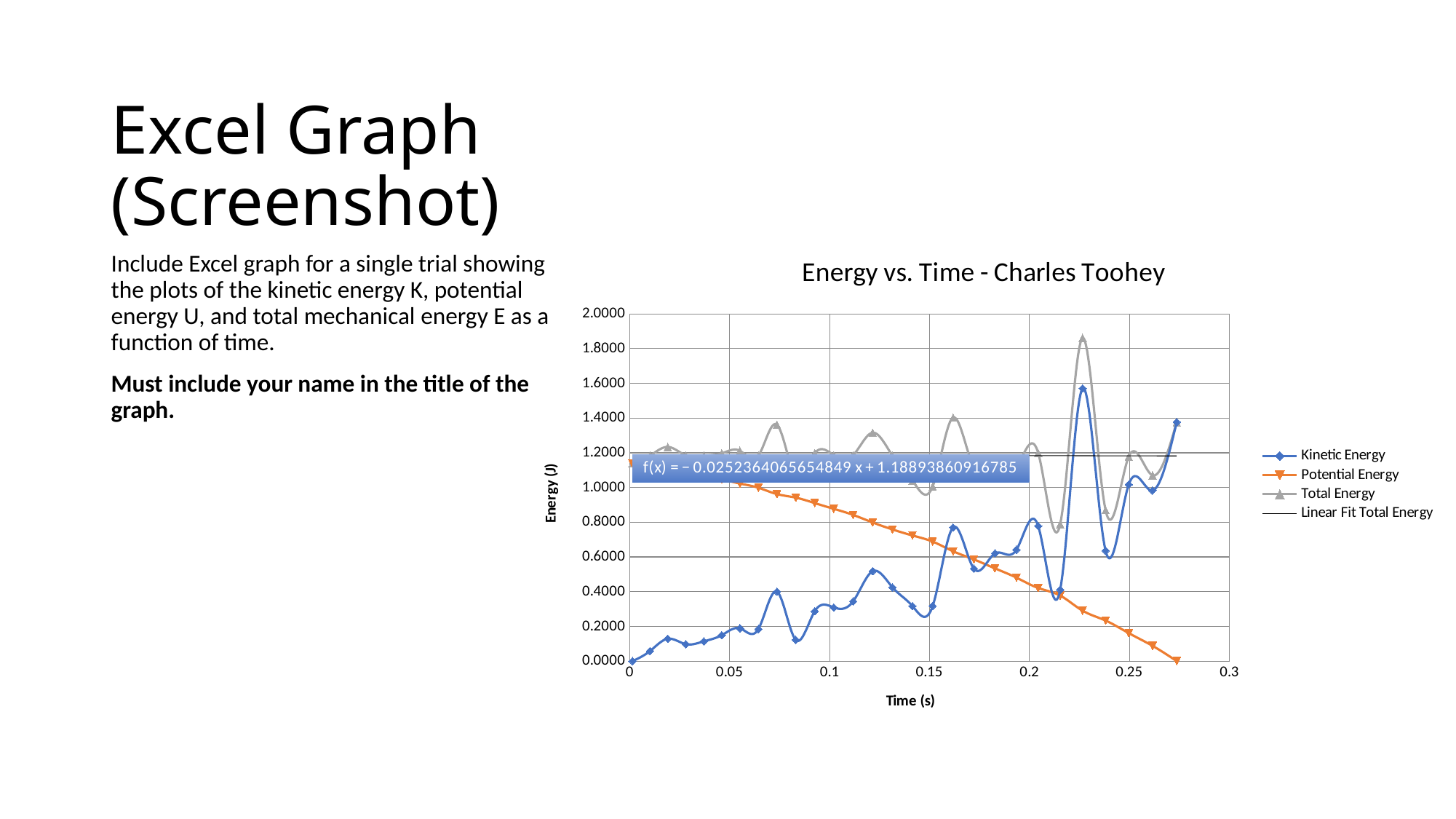
What is the title of the chart? Energy vs. Time - Charles Toohey Is the Potential Energy value at time 0 greater or less than 1.0000? greater What is the label of the chart's x axis? Time (s) How many series does the chart legend list? 4 What is the Kinetic Energy value at time 0? 0.0000 At time 0.1, which is larger: Kinetic Energy or Potential Energy? Potential Energy Which series reaches the highest value on the chart? Total Energy Is the highest Total Energy value greater or less than 1.8000? greater What kind of chart is shown on the slide? line chart Is the Potential Energy value at time 0.1 greater or less than 1.0000? less Does the Potential Energy series rise or fall as time increases? fall